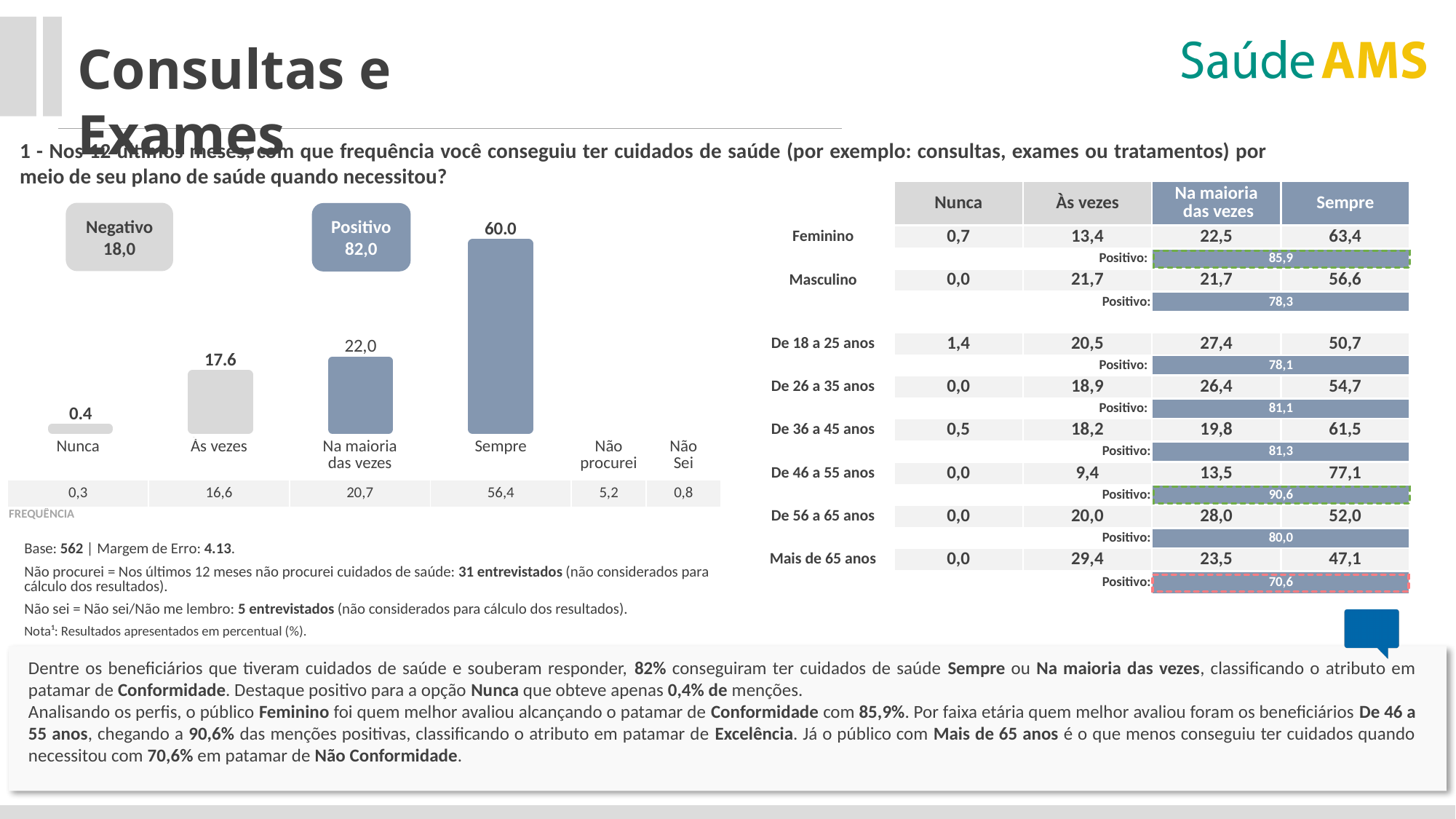
What value is shown in the Positivo box above the bar chart? 82,0 In the bar chart, which category has the highest value? Sempre In the bar chart, what is the value for Às vezes? 17.6 In the table on the right, what is the Positivo value for De 46 a 55 anos? 90,6 In the bar chart, what is the value for Na maioria das vezes? 22,0 In the bar chart, what is the difference between the value for Sempre and the value for Na maioria das vezes? 38.0 In the bar chart, what is the value for Sempre? 60.0 In the bar chart, what is the value for Nunca? 0.4 What kind of chart is shown on the left of the slide? bar chart What value is shown in the Negativo box above the bar chart? 18,0 In the bar chart, which category has the lowest plotted value? Nunca In the bar chart, which is larger: the value for Às vezes or the value for Na maioria das vezes? Na maioria das vezes